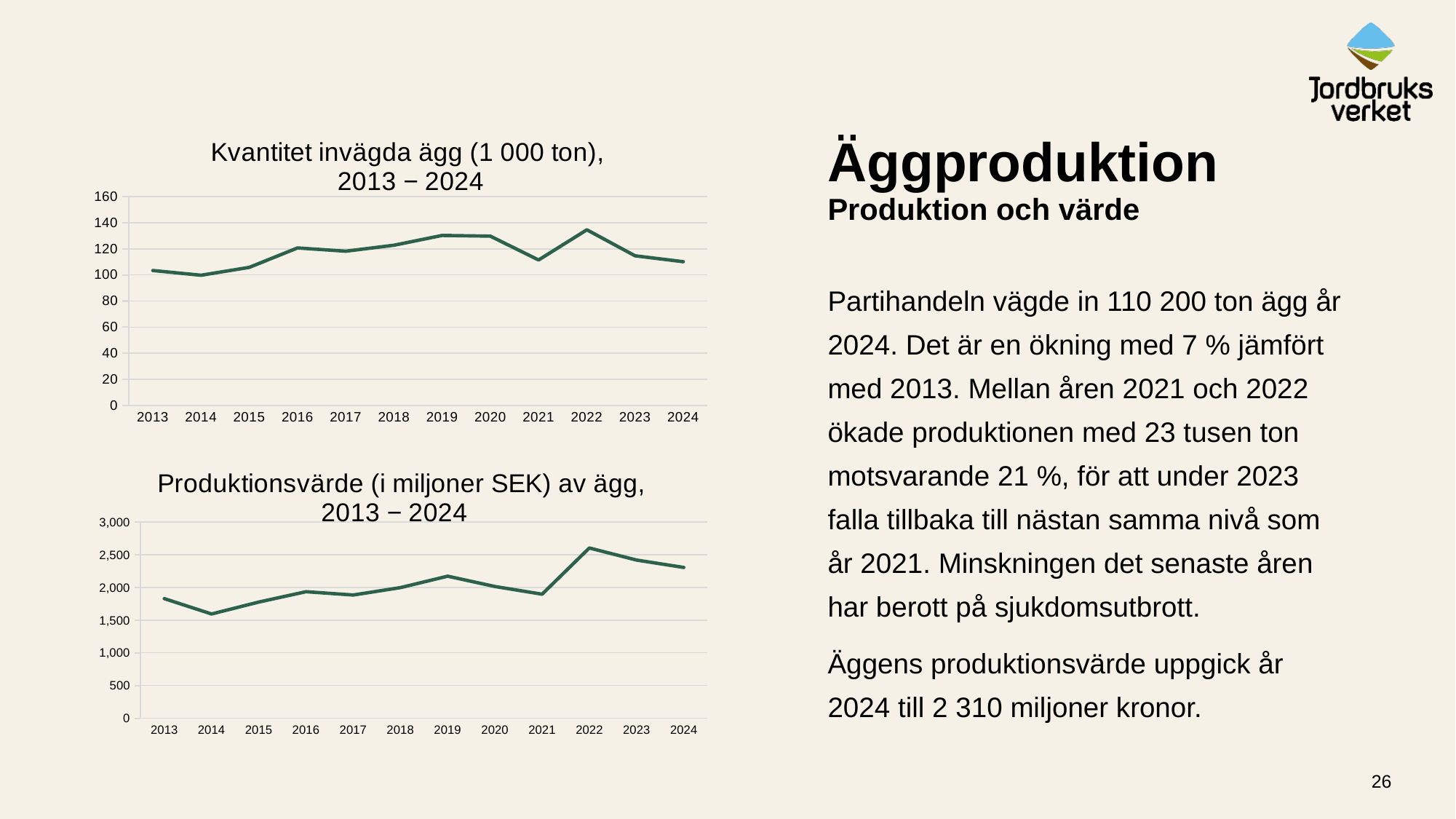
In the bottom chart 'Produktionsvärde (i miljoner SEK) av ägg', which year has the lowest value? 2014 How many years are plotted in the top chart 'Kvantitet invägda ägg'? 12 In the top chart 'Kvantitet invägda ägg', do the values rise or fall from 2022 to 2024? Fall In the top chart 'Kvantitet invägda ägg', which year has the highest value? 2022 In the top chart 'Kvantitet invägda ägg', is the value for 2022 greater or less than 120? greater In the top chart 'Kvantitet invägda ägg', is the value for 2021 greater or less than 120? less In the bottom chart 'Produktionsvärde (i miljoner SEK) av ägg', is the value for 2022 greater or less than 2,500? greater In the top chart 'Kvantitet invägda ägg', which year has the lowest value? 2014 In the bottom chart 'Produktionsvärde (i miljoner SEK) av ägg', which year has the highest value? 2022 What is the title of the bottom chart on the slide? Produktionsvärde (i miljoner SEK) av ägg, 2013 − 2024 What kind of chart is the top chart, 'Kvantitet invägda ägg (1 000 ton), 2013 − 2024'? Line chart